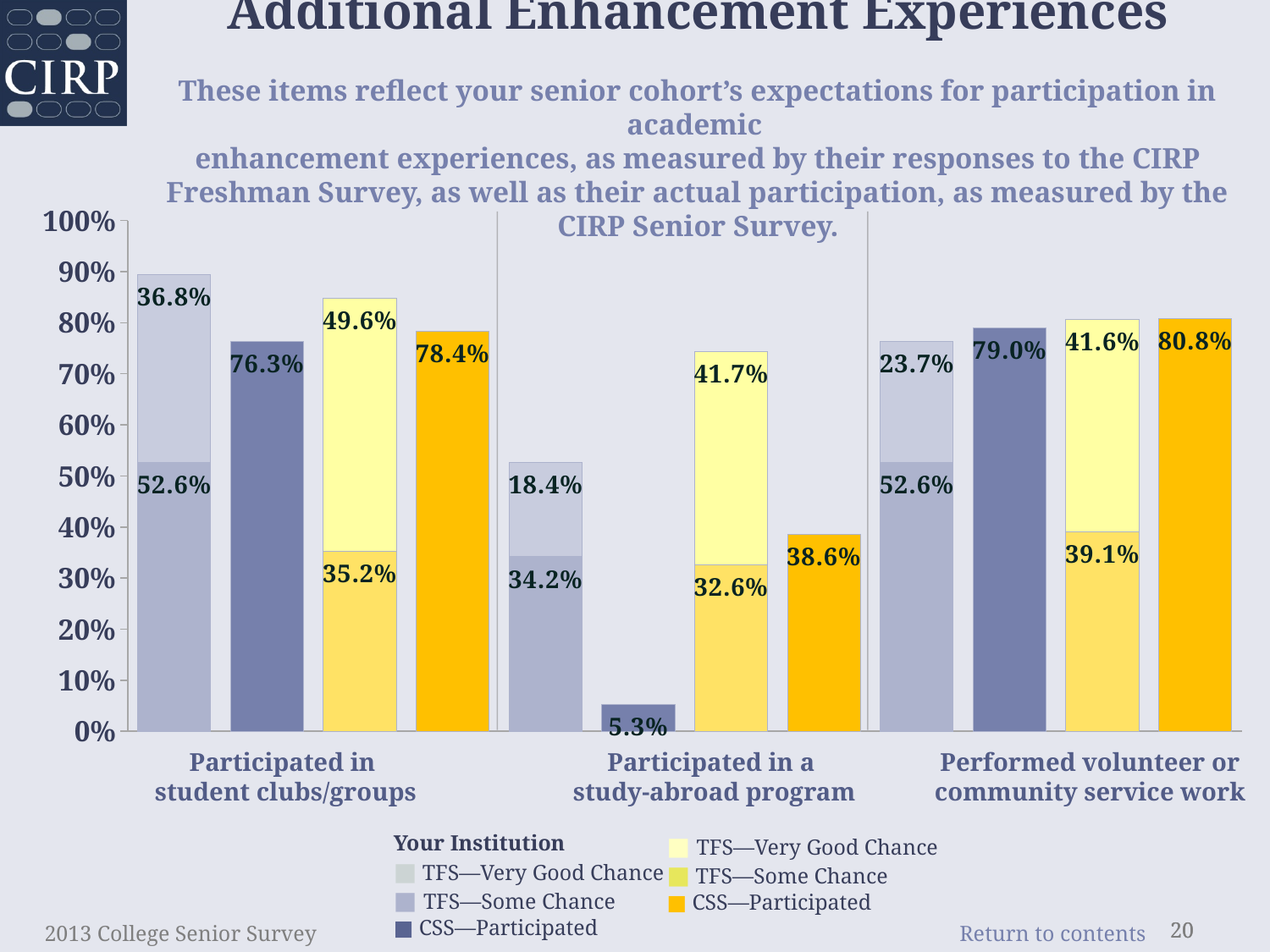
How many categories are shown on the x axis of the chart? 3 What is the Your Institution CSS—Participated value for 'Participated in a study-abroad program'? 5.3% Which category has the lowest Your Institution CSS—Participated value? Participated in a study-abroad program What is the Your Institution TFS—Very Good Chance value for 'Performed volunteer or community service work'? 23.7% For 'Participated in a study-abroad program', what is the difference between the comparison group's CSS—Participated value and Your Institution's CSS—Participated value? 33.3 percentage points What kind of chart is shown on the slide? Stacked bar chart What is the total of the comparison group's TFS stacked bar (Some Chance plus Very Good Chance) for 'Participated in a study-abroad program'? 74.3% What is the comparison group's CSS—Participated value for 'Performed volunteer or community service work'? 80.8% For 'Performed volunteer or community service work', which is larger: Your Institution's CSS—Participated value or the comparison group's CSS—Participated value? The comparison group's CSS—Participated value What is the total of the Your Institution TFS stacked bar (Some Chance plus Very Good Chance) for 'Participated in student clubs/groups'? 89.4% How many series does the legend list? 6 Which category has the highest Your Institution CSS—Participated value? Performed volunteer or community service work